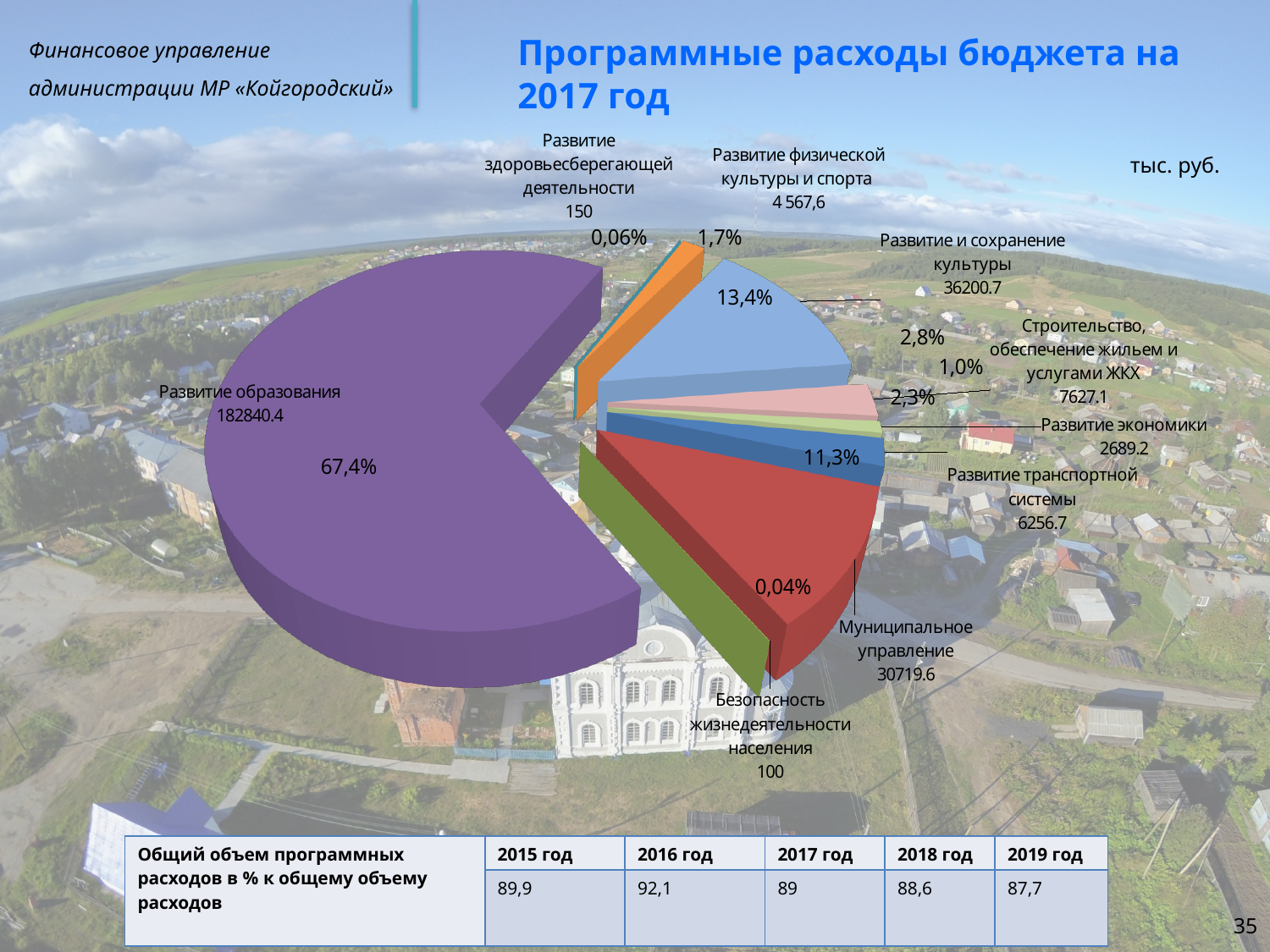
What kind of chart is shown on the slide? pie chart How many categories are shown in the pie chart? 9 What is the value for Развитие транспортной системы? 6256.7 Which category has the smallest slice of the pie? Безопасность жизнедеятельности населения Which category has the largest slice of the pie? Развитие образования What is the value for Развитие физической культуры и спорта? 4 567,6 What is the value for Муниципальное управление? 30719.6 What is the value for Развитие и сохранение культуры? 36200.7 What is the difference between the values for Строительство, обеспечение жильем и услугами ЖКХ and Развитие экономики? 4937.9 Which is larger: Развитие и сохранение культуры or Муниципальное управление? Развитие и сохранение культуры What is the value for Развитие образования? 182840.4 What share of the pie does Развитие образования take? 67,4%